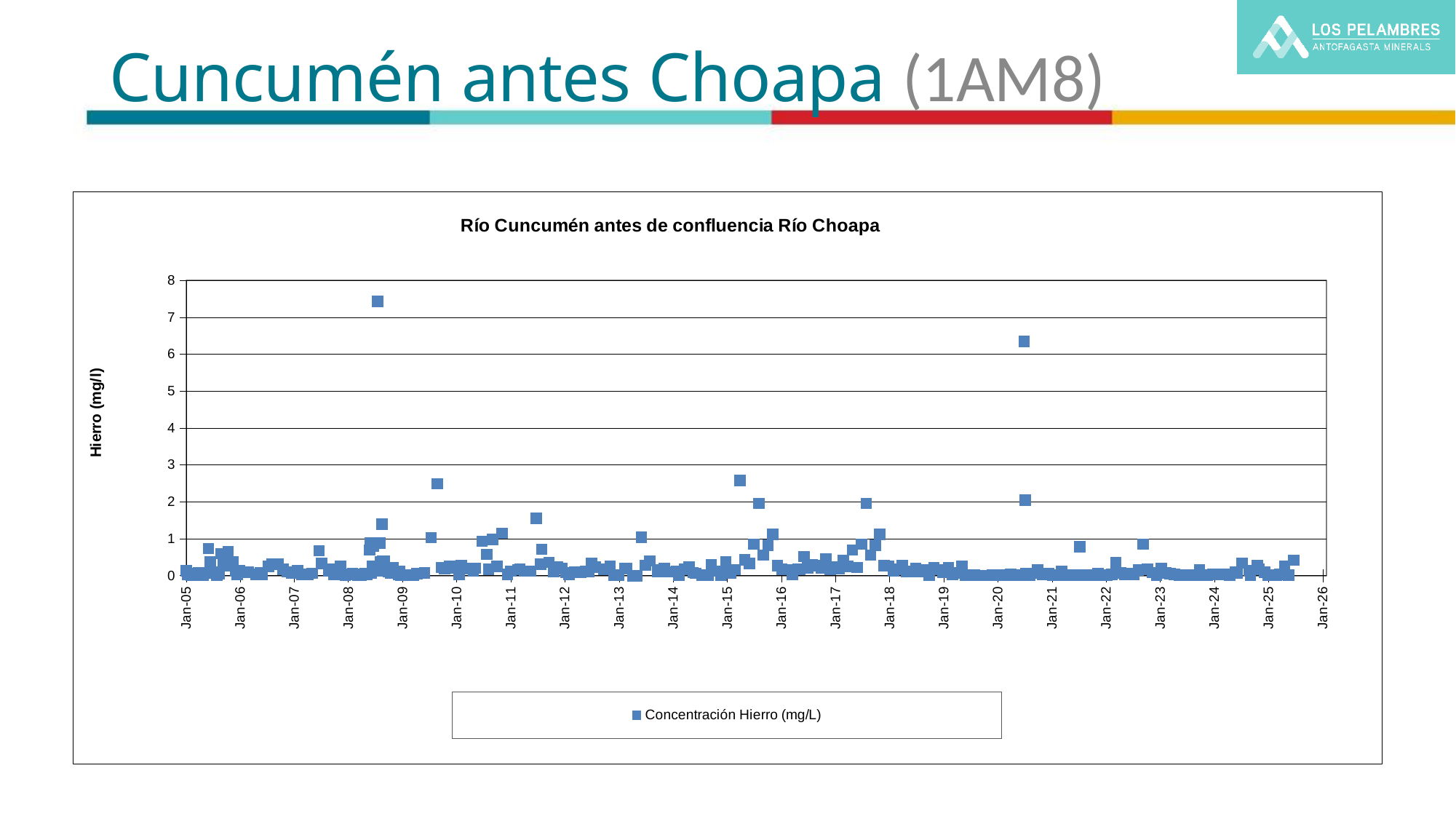
Is the peak value plotted between Jan-15 and Jan-16 greater or less than 3? less What is the maximum value shown on the vertical axis? 8 Is the peak value plotted between Jan-20 and Jan-21 greater or less than 6? greater What is the name of the series shown in the legend? Concentración Hierro (mg/L) Is the peak value plotted between Jan-20 and Jan-21 greater or less than 7? less What is the title of the chart? Río Cuncumén antes de confluencia Río Choapa How many series does the chart legend list? 1 Which is larger: the highest point between Jan-08 and Jan-09, or the highest point between Jan-20 and Jan-21? The highest point between Jan-08 and Jan-09 What kind of chart is shown on the slide? Scatter chart